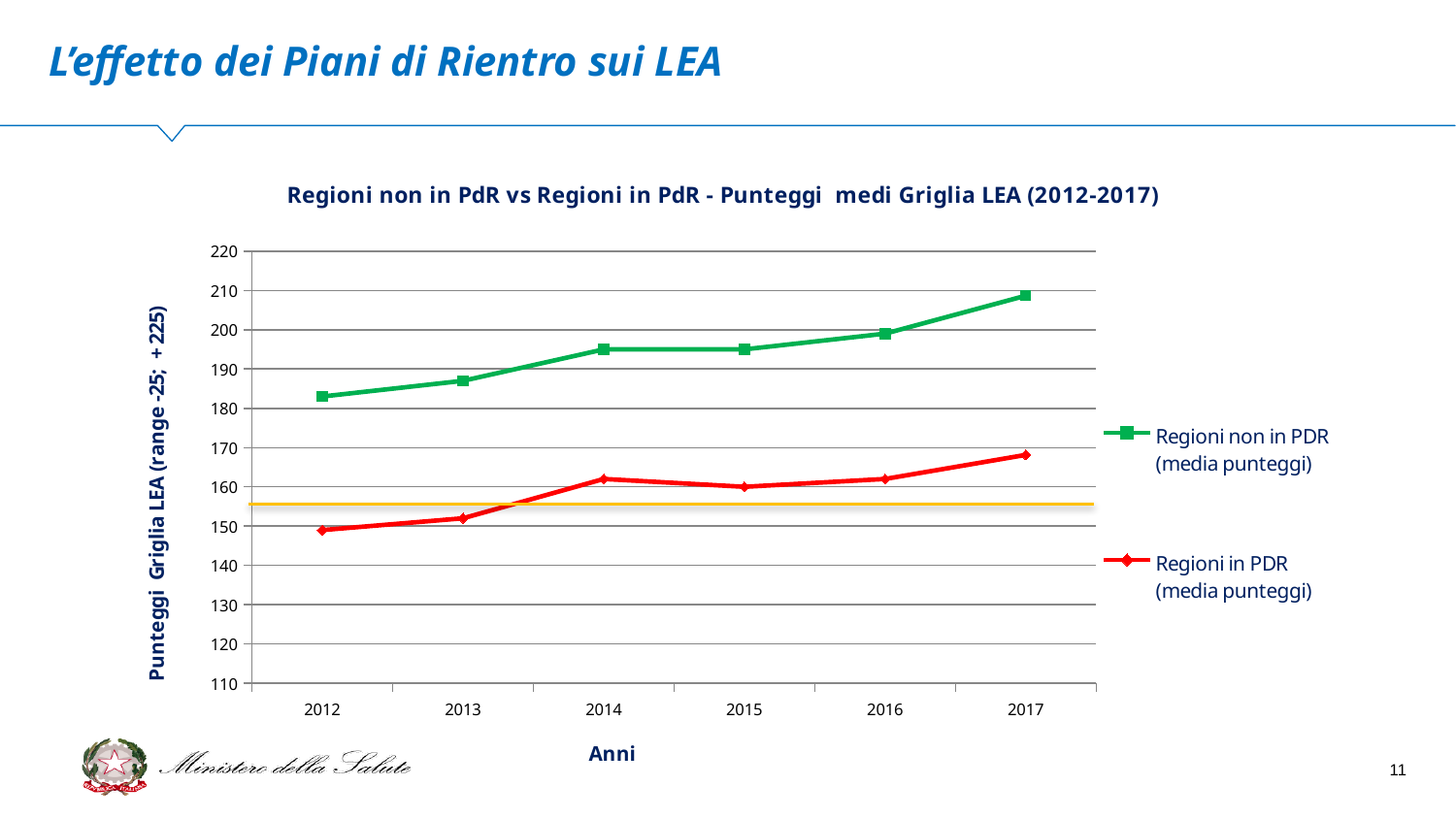
What kind of chart is shown on the slide? line chart What is the title of the chart? Regioni non in PdR vs Regioni in PdR - Punteggi medi Griglia LEA (2012-2017) Do the values for Regioni in PDR (media punteggi) generally rise or fall from 2012 to 2017? rise How many years are plotted along the x axis? 6 In which year is the value for Regioni non in PDR (media punteggi) highest? 2017 Is the value for Regioni in PDR (media punteggi) in 2017 greater or less than 160? greater Is the value for Regioni non in PDR (media punteggi) in 2017 greater or less than 200? greater In which year is the value for Regioni in PDR (media punteggi) lowest? 2012 Is the value for Regioni in PDR (media punteggi) in 2012 greater or less than 160? less How many series does the legend list? 2 In 2012, which series has the larger value: Regioni non in PDR or Regioni in PDR? Regioni non in PDR